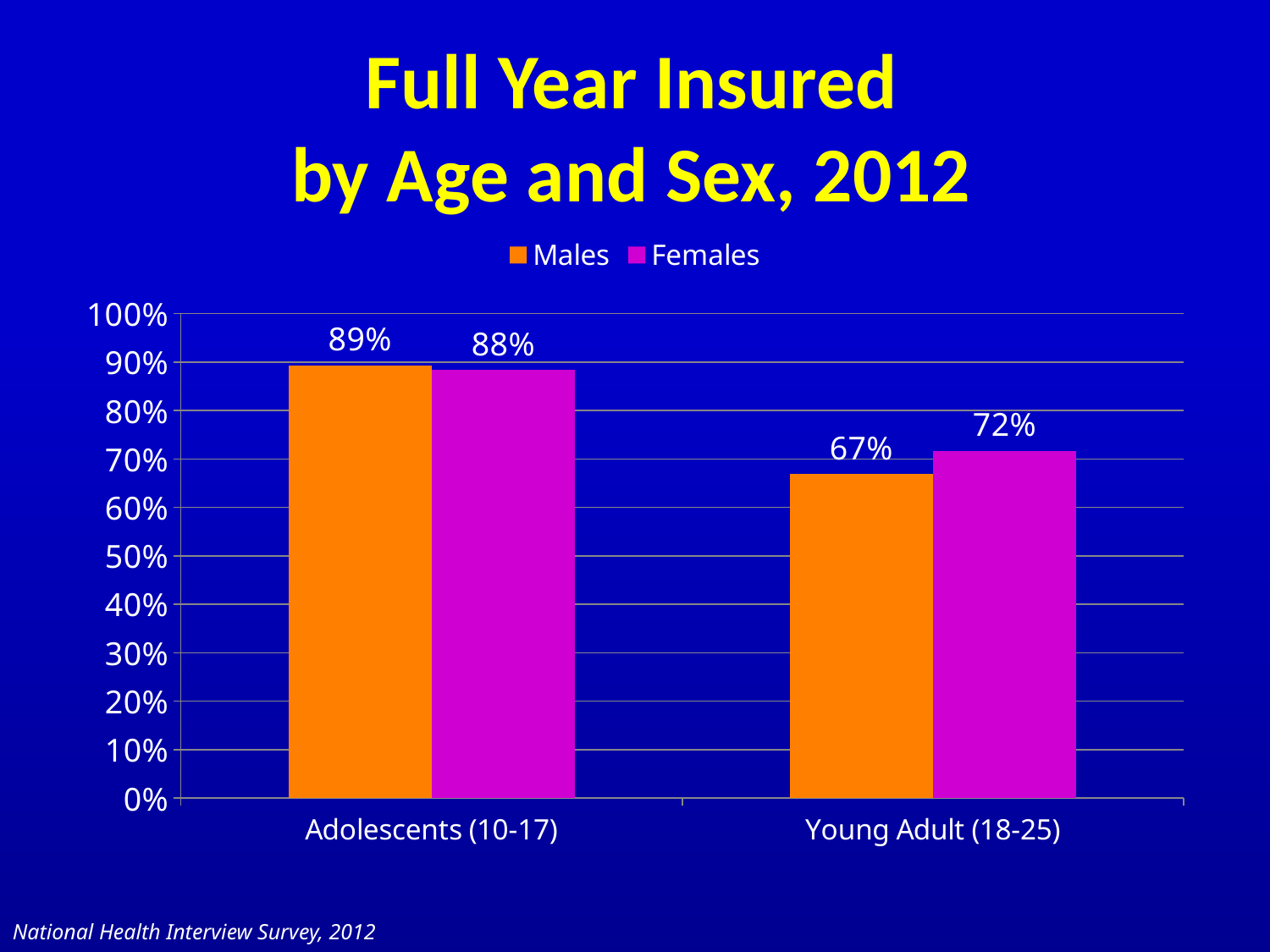
Which group has the lowest full-year insured percentage? Young Adult (18-25) Males Among Young Adults (18-25), which sex has the higher full-year insured percentage? Females What percentage of young adult (18-25) males were insured for the full year? 67% How many series does the legend list? 2 What type of chart is shown on the slide? Bar chart What percentage of young adult (18-25) females were insured for the full year? 72% How many age categories are shown on the x axis? 2 What is the difference between the male full-year insured percentages for Adolescents (10-17) and Young Adults (18-25)? 22% What percentage of adolescent (10-17) males were insured for the full year? 89% Which group has the highest full-year insured percentage? Adolescents (10-17) Males What is the difference between the female and male full-year insured percentages for Young Adults (18-25)? 5% What percentage of adolescent (10-17) females were insured for the full year? 88%